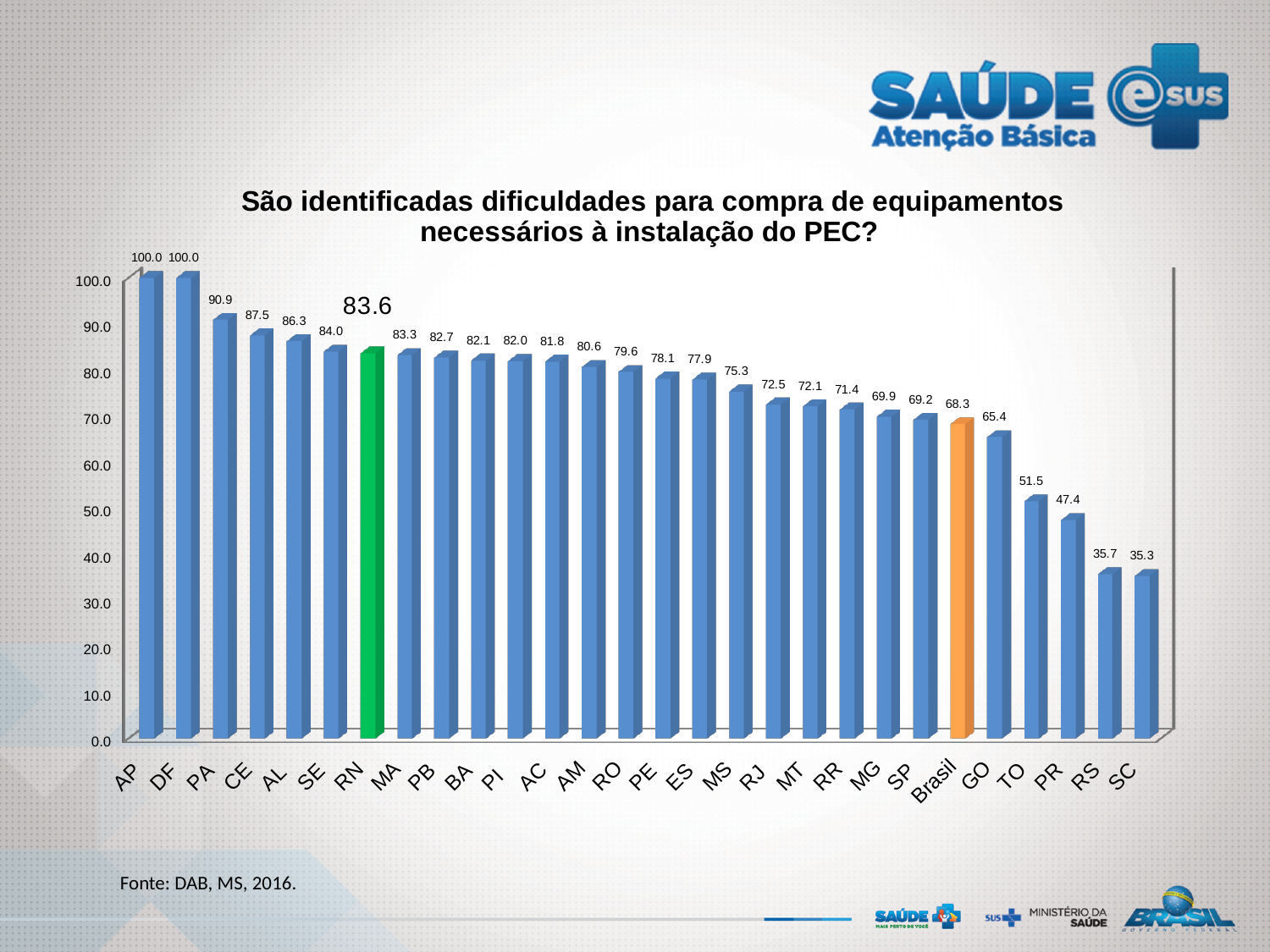
What is the value for RN? 83.6 How many categories are shown on the x axis? 28 Which is larger, the value for GO or the value for TO? GO What kind of chart is shown on the slide? bar chart Do the values rise or fall from left to right along the x axis? fall What is the difference between the values for RN and Brasil? 15.3 What is the difference between the values for AP and SC? 64.7 Which category has the lowest value? SC What is the value for Brasil? 68.3 What is the value for PA? 90.9 What is the value for SC? 35.3 What colour is the bar for Brasil? orange